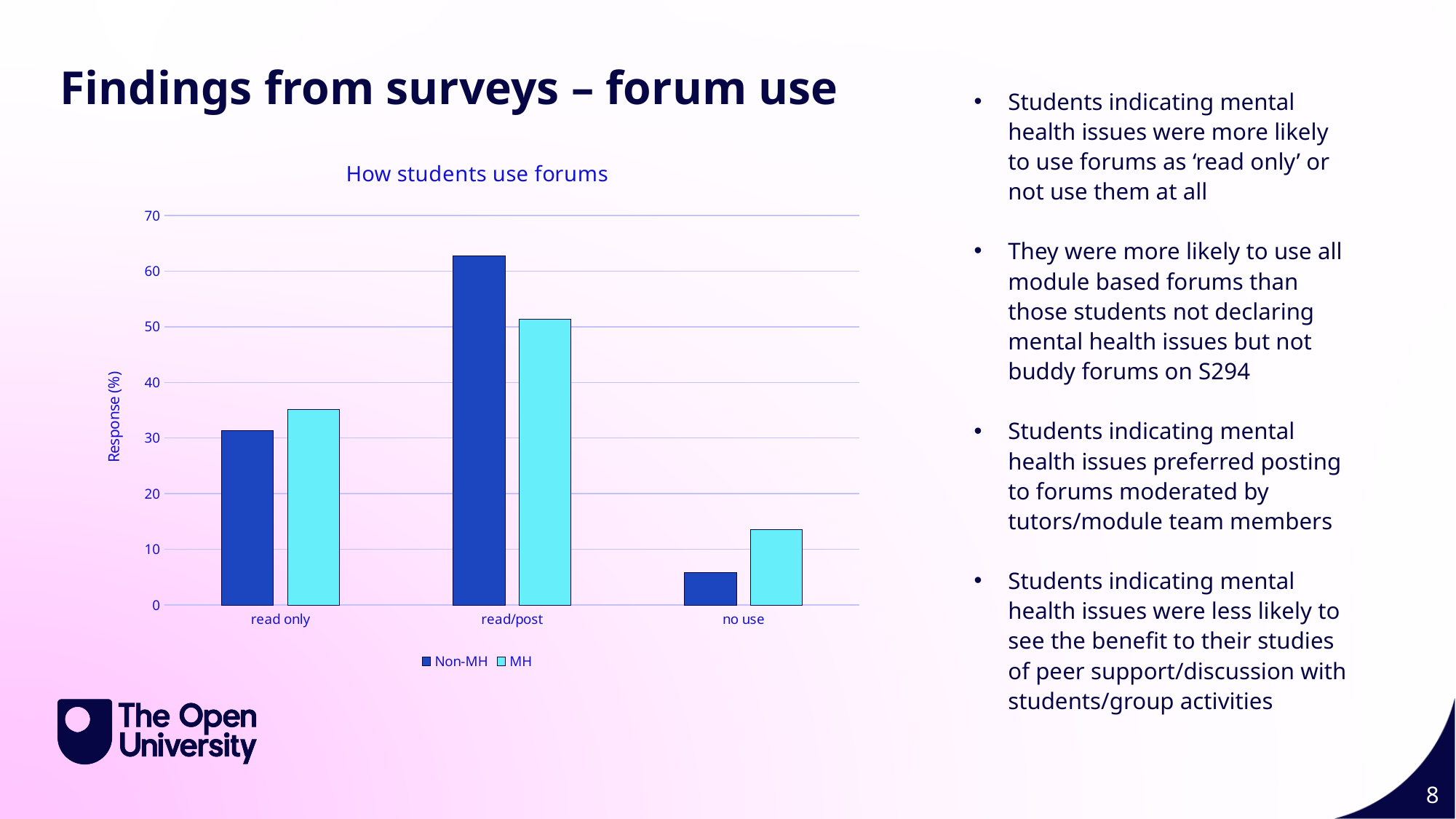
What is the title of the chart? How students use forums For the read only category, which series has the larger value, Non-MH or MH? MH Which category has the highest Non-MH value? read/post What type of chart is shown on the slide? bar chart How many series does the legend list? 2 Which category has the lowest MH value? no use Is the MH value for read/post greater or less than 60? less What is the label on the vertical axis? Response (%) For the no use category, which series has the larger value, Non-MH or MH? MH Is the Non-MH value for no use greater or less than 10? less Is the Non-MH value for read/post greater or less than 60? greater How many categories are shown on the x axis? 3